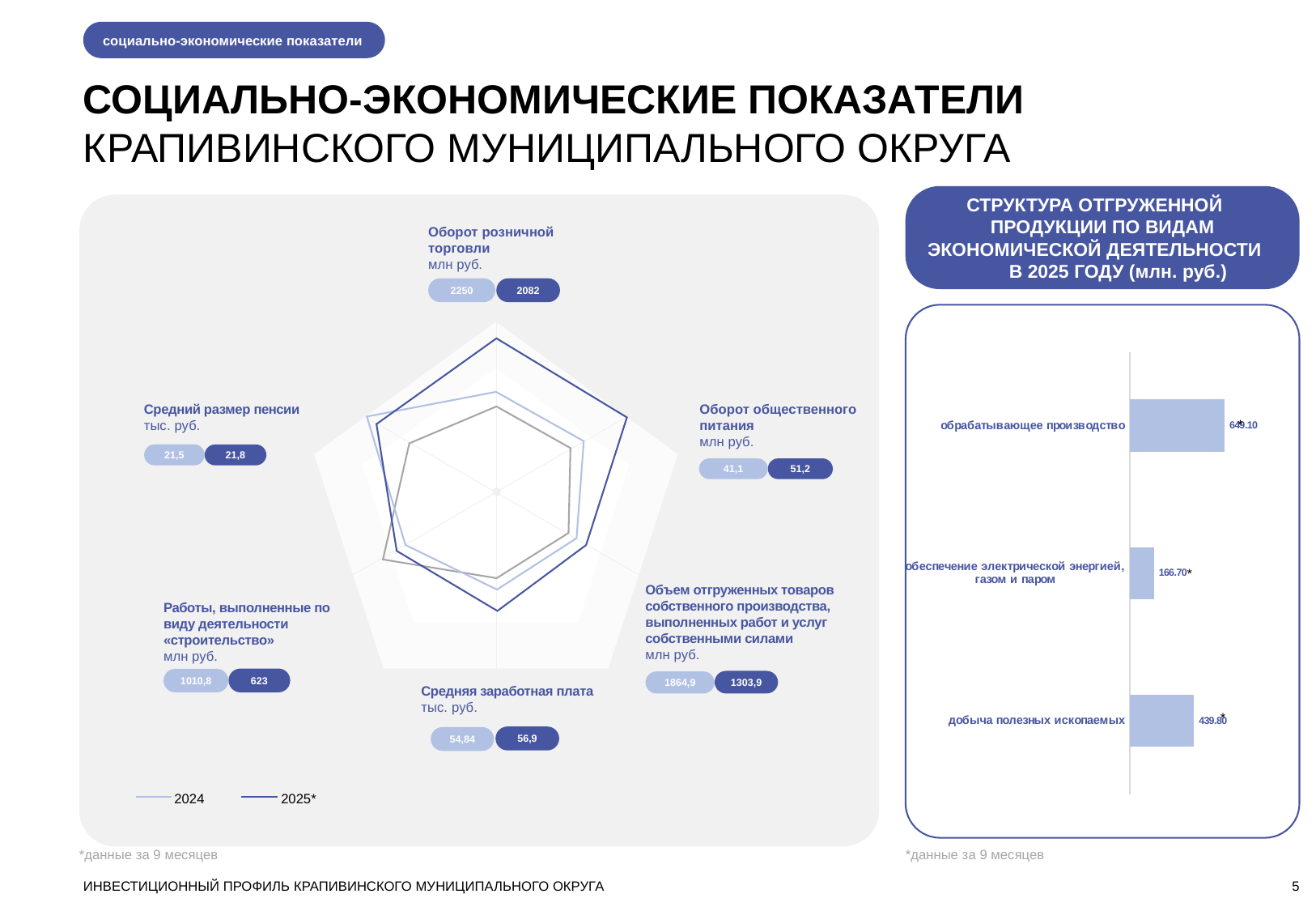
In the radar chart on the left of the slide, which year has the larger value for 'Работы, выполненные по виду деятельности «строительство»', 2024 or 2025*? 2024 In the chart on the right of the slide, which category has the lowest value? обеспечение электрической энергией, газом и паром How many series does the legend of the radar chart on the left of the slide list? 2 In the chart on the right of the slide, which category has the highest value? обрабатывающее производство In the radar chart on the left of the slide, what is the 2025* value for 'Оборот розничной торговли'? 2082 What kind of chart is the chart titled 'СТРУКТУРА ОТГРУЖЕННОЙ ПРОДУКЦИИ ПО ВИДАМ ЭКОНОМИЧЕСКОЙ ДЕЯТЕЛЬНОСТИ В 2025 ГОДУ'? Bar chart In the radar chart on the left of the slide, what is the difference between the 2025* and 2024 values for 'Оборот общественного питания'? 10,1 How many categories are shown in the chart on the right of the slide (structure of shipped products in 2025)? 3 In the chart on the right of the slide, what is the value for 'добыча полезных ископаемых'? 439.80 In the chart on the right of the slide, what is the value for 'обеспечение электрической энергией, газом и паром'? 166.70 In the chart on the right of the slide, what is the difference between the values for 'добыча полезных ископаемых' and 'обеспечение электрической энергией, газом и паром'? 273.10 In the radar chart on the left of the slide, what is the 2024 value for 'Средний размер пенсии'? 21,5